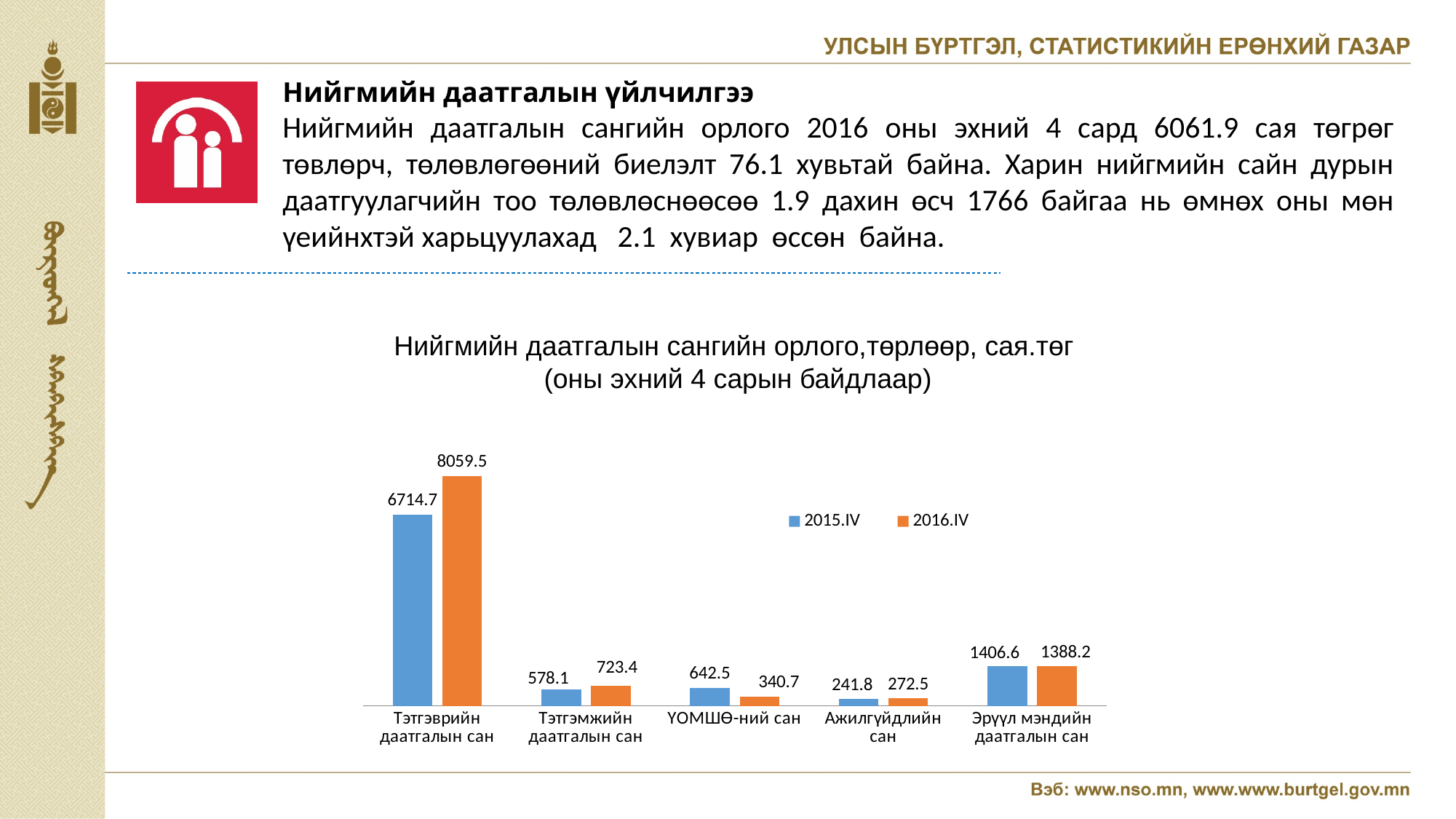
For ҮОМШӨ-ний сан, which is larger: the 2015.IV value or the 2016.IV value? 2015.IV Which category has the lowest 2015.IV value? Ажилгүйдлийн сан Which category has the highest 2016.IV value? Тэтгэврийн даатгалын сан How many categories are shown on the x axis of the chart? 5 What is the 2016.IV value for Тэтгэврийн даатгалын сан? 8059.5 What is the 2015.IV value for ҮОМШӨ-ний сан? 642.5 What kind of chart is shown on the slide? Bar chart What is the 2015.IV value for Эрүүл мэндийн даатгалын сан? 1406.6 What is the 2016.IV value for Ажилгүйдлийн сан? 272.5 What are the two series names listed in the chart legend? 2015.IV and 2016.IV What is the difference between the 2016.IV and 2015.IV values for Тэтгэврийн даатгалын сан? 1344.8 How many series does the chart legend list? 2